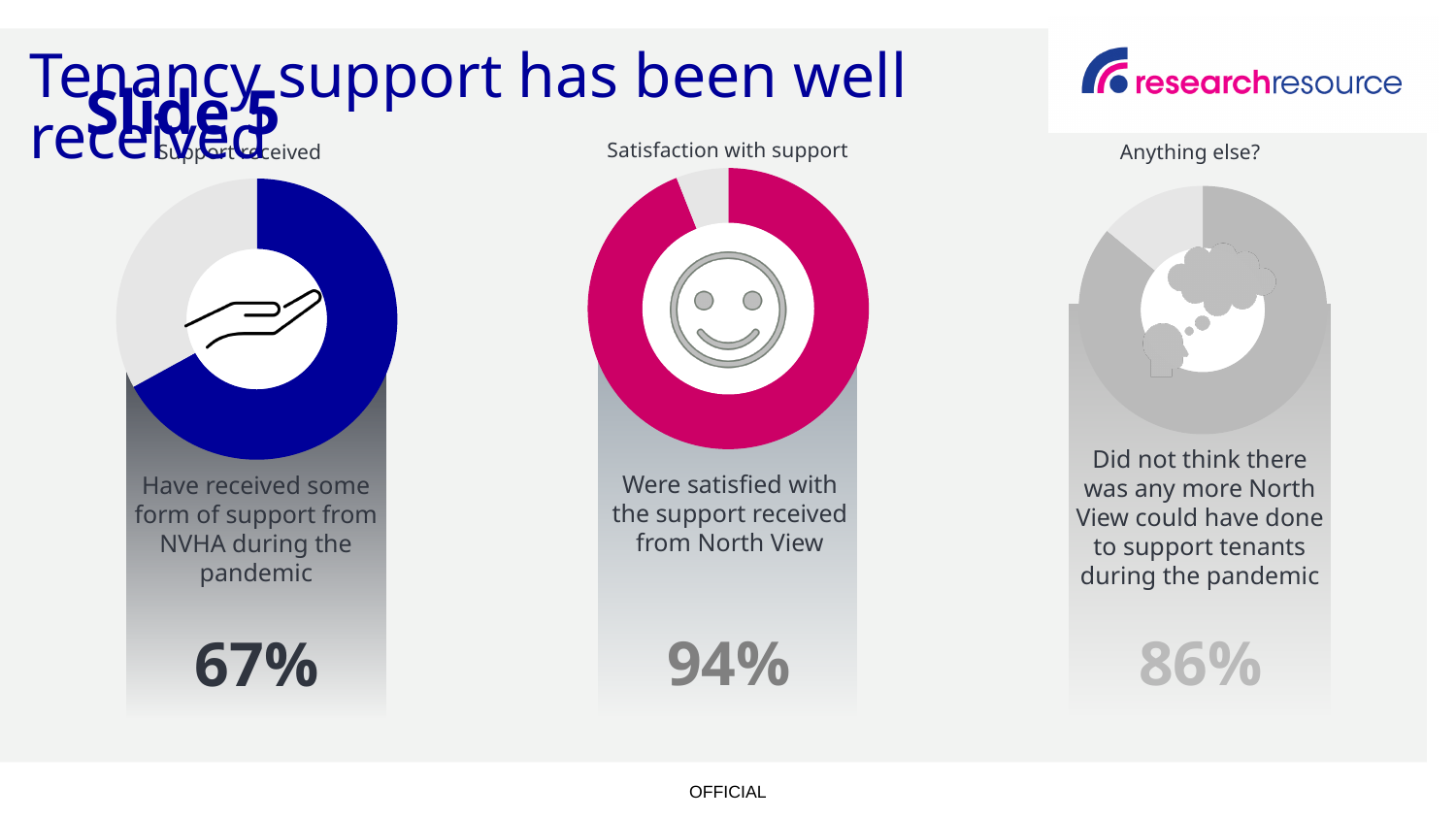
Is the percentage shown on the 'Satisfaction with support' chart greater or less than 50%? greater On the left chart (Support received), what percentage of tenants have received some form of support from NVHA during the pandemic? 67% What colour is the highlighted slice on the 'Satisfaction with support' chart? pink/magenta Which of the three charts shows the lowest percentage? Support received (67%) On the 'Satisfaction with support' chart, what percentage were satisfied with the support received from North View? 94% What is the difference between the percentage on the 'Satisfaction with support' chart and the percentage on the 'Support received' chart? 27 percentage points Which is larger: the percentage on the 'Anything else?' chart or the percentage on the 'Support received' chart? Anything else? (86%) Which of the three charts shows the highest percentage? Satisfaction with support (94%) What is the difference between the percentage on the 'Satisfaction with support' chart and the percentage on the 'Anything else?' chart? 8 percentage points How many charts are shown on the slide? 3 What kind of chart is used for each of the three figures on the slide? pie chart (donut) On the 'Anything else?' chart, what percentage did not think there was any more North View could have done to support tenants during the pandemic? 86%